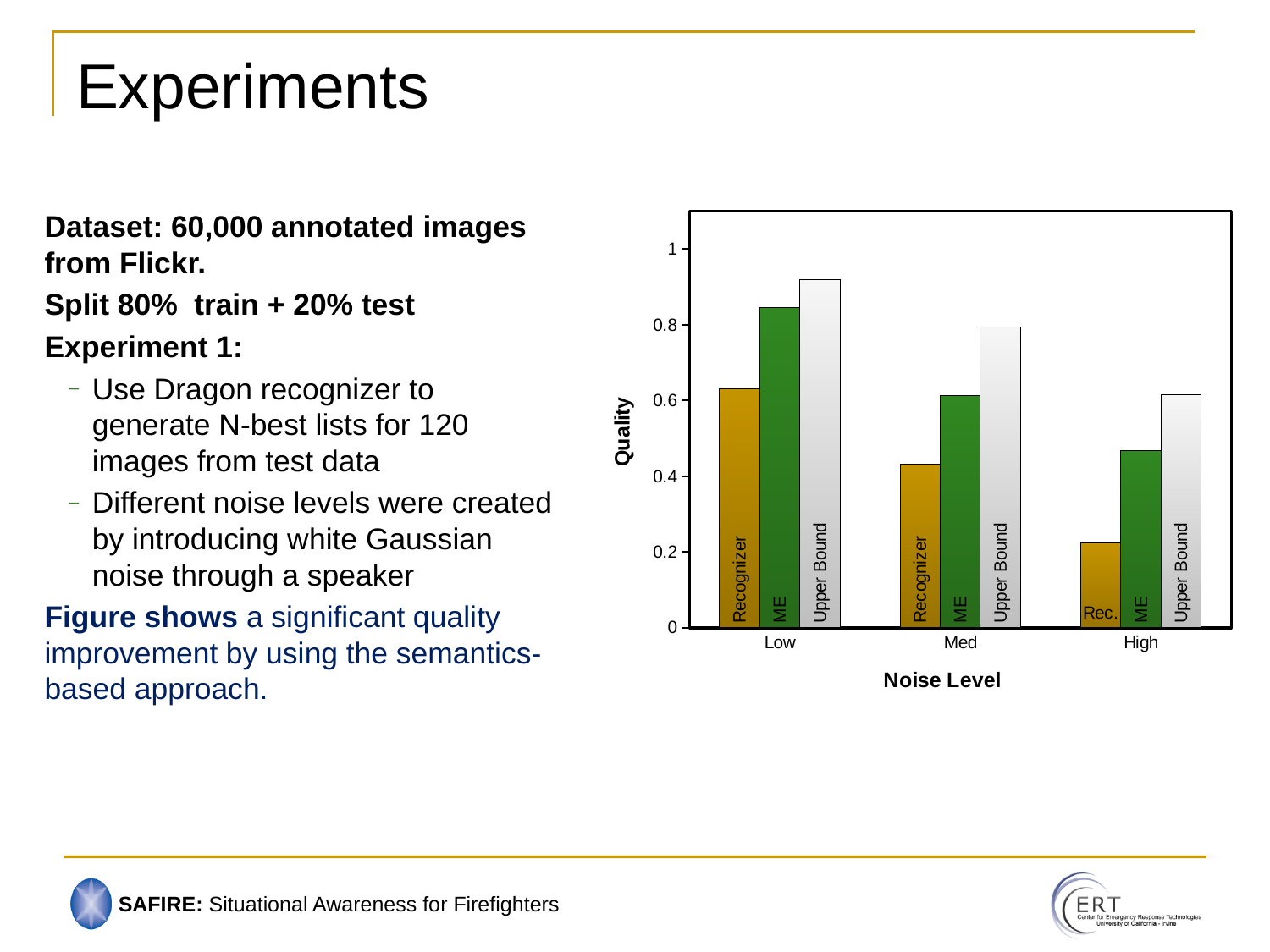
What is the title of the y axis of the chart? Quality Which is larger in the chart: ME at Low or ME at Med? ME at Low Is the value for Rec. at the High noise level greater or less than 0.4? less Which bar in the chart is the lowest overall? Recognizer (Rec.) at High Which bar in the chart is the highest overall? Upper Bound at Low What is the title of the x axis of the chart? Noise Level Is the value for ME at the Low noise level greater or less than 0.8? greater How many series (bar types) are shown within each noise level group in the chart? 3 Is the value for Recognizer at the Med noise level greater or less than 0.6? less Do the Recognizer values rise or fall as the noise level goes from Low to High? fall How many noise level categories are shown on the x axis of the chart? 3 What kind of chart is shown on the slide? bar chart